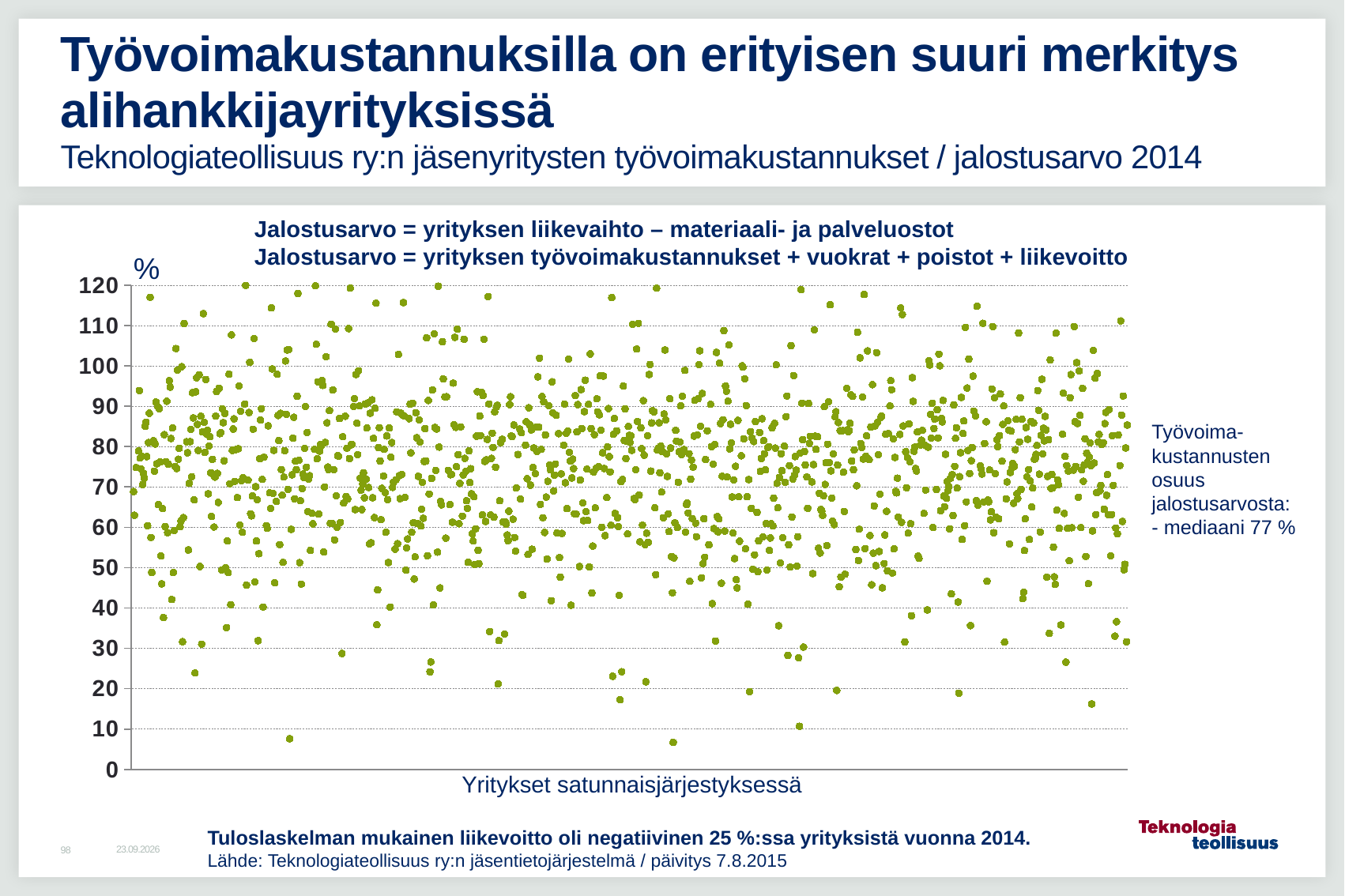
What unit is shown at the top of the vertical axis? % What is the label of the horizontal axis of the chart? Yritykset satunnaisjärjestyksessä What year does the chart's data refer to, according to the subtitle? 2014 What is the highest value shown on the vertical axis of the chart? 120 What is the lowest value shown on the vertical axis of the chart? 0 Is the stated median value of 77 % greater or less than 80 on the vertical axis? less Is the stated median value of 77 % greater or less than 70 on the vertical axis? greater What kind of chart is shown on the slide? scatter chart What is the median share of labour costs in value added stated next to the chart? 77 % According to the note below the chart, in what share of companies was operating profit negative in 2014? 25 %